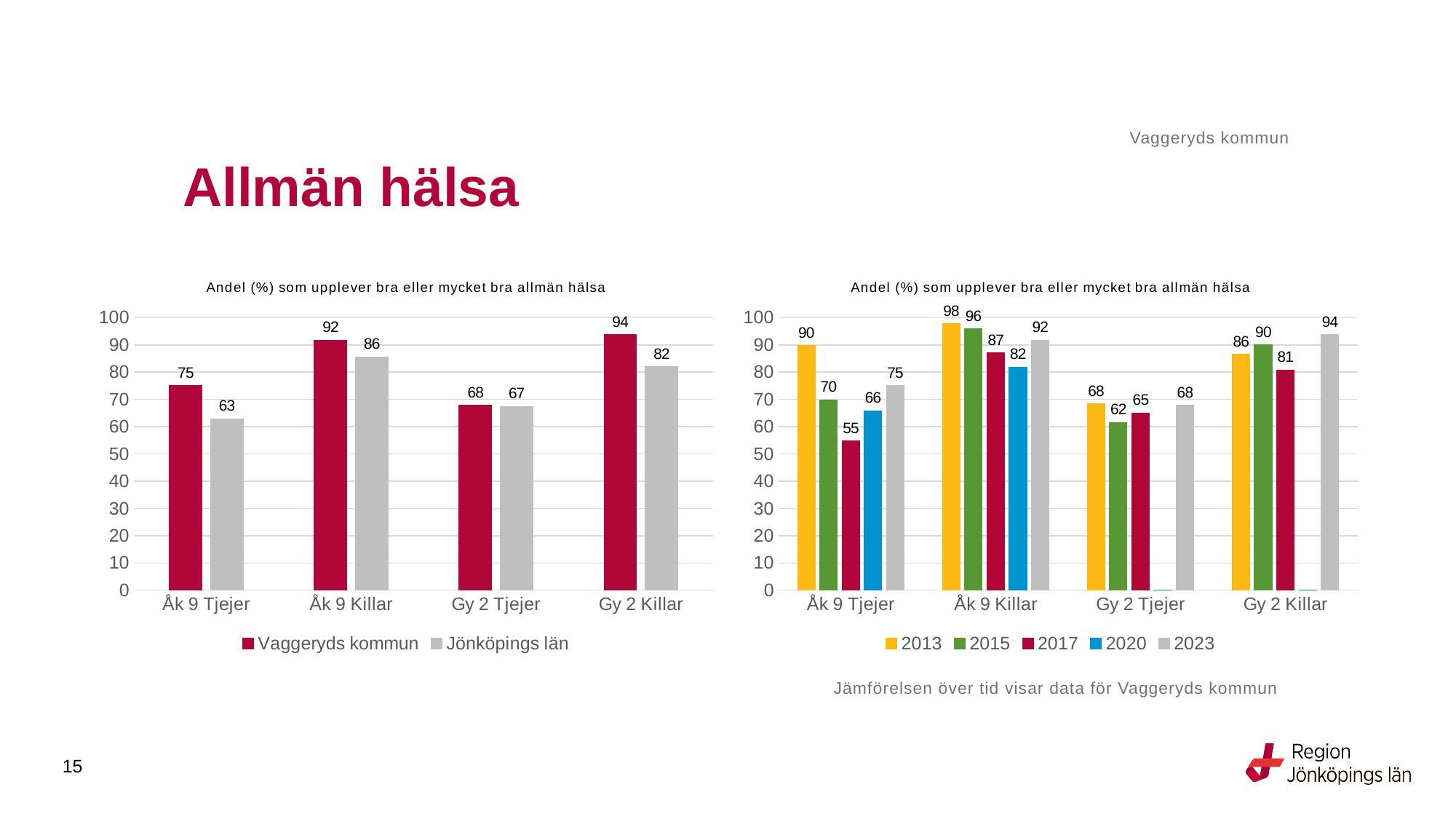
In the left chart, which category has the highest value for Vaggeryds kommun? Gy 2 Killar In the right chart, which is larger for Åk 9 Killar: the value for 2013 or the value for 2020? 2013 What kind of chart is the left chart? Bar chart In the left chart, what is the value for Vaggeryds kommun for Åk 9 Tjejer? 75 In the left chart, how many series does the legend list? 2 In the right chart, what is the value for 2017 for Åk 9 Tjejer? 55 In the left chart, what is the difference between Vaggeryds kommun and Jönköpings län for Åk 9 Tjejer? 12 In the right chart, what is the difference between the 2013 and 2023 values for Åk 9 Tjejer? 15 In the right chart, how many series does the legend list? 5 In the right chart, what is the value for 2023 for Gy 2 Killar? 94 In the left chart, what is the value for Jönköpings län for Gy 2 Killar? 82 In the right chart, which year has the lowest value for Åk 9 Tjejer? 2017